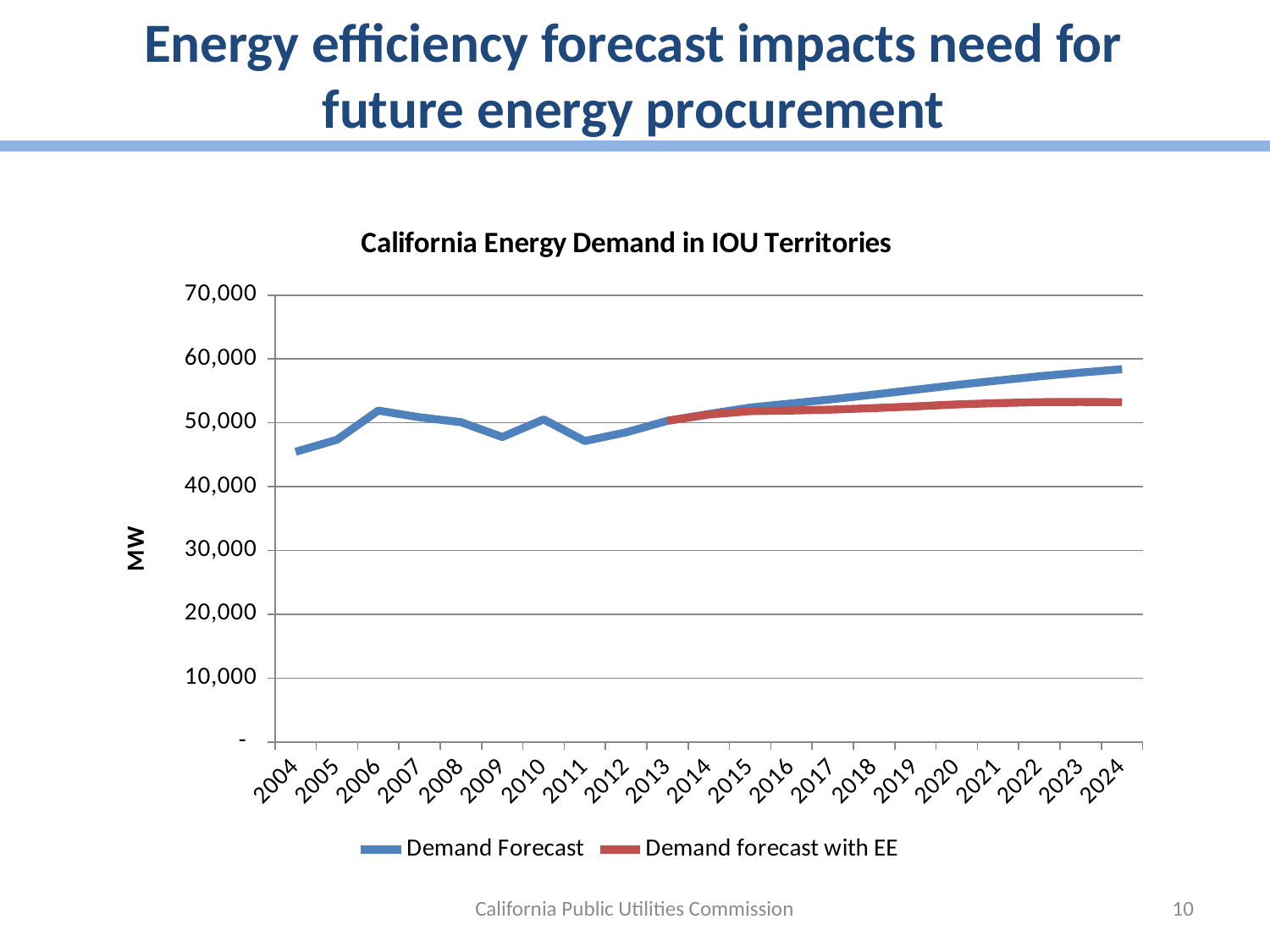
Is the Demand Forecast value for 2004 greater or less than 50,000? less Does the Demand Forecast series rise or fall from 2013 to 2024? Rise In which year does the Demand Forecast series reach its highest value? 2024 How many years are shown along the x axis? 21 What is the title of the chart? California Energy Demand in IOU Territories How many series does the legend list? 2 In 2024, which series has the larger value: Demand Forecast or Demand forecast with EE? Demand Forecast Is the Demand Forecast value for 2024 greater or less than 50,000? greater Is the Demand Forecast value for 2011 greater or less than 50,000? less What kind of chart is shown on the slide? Line chart What unit is shown on the y axis label? MW